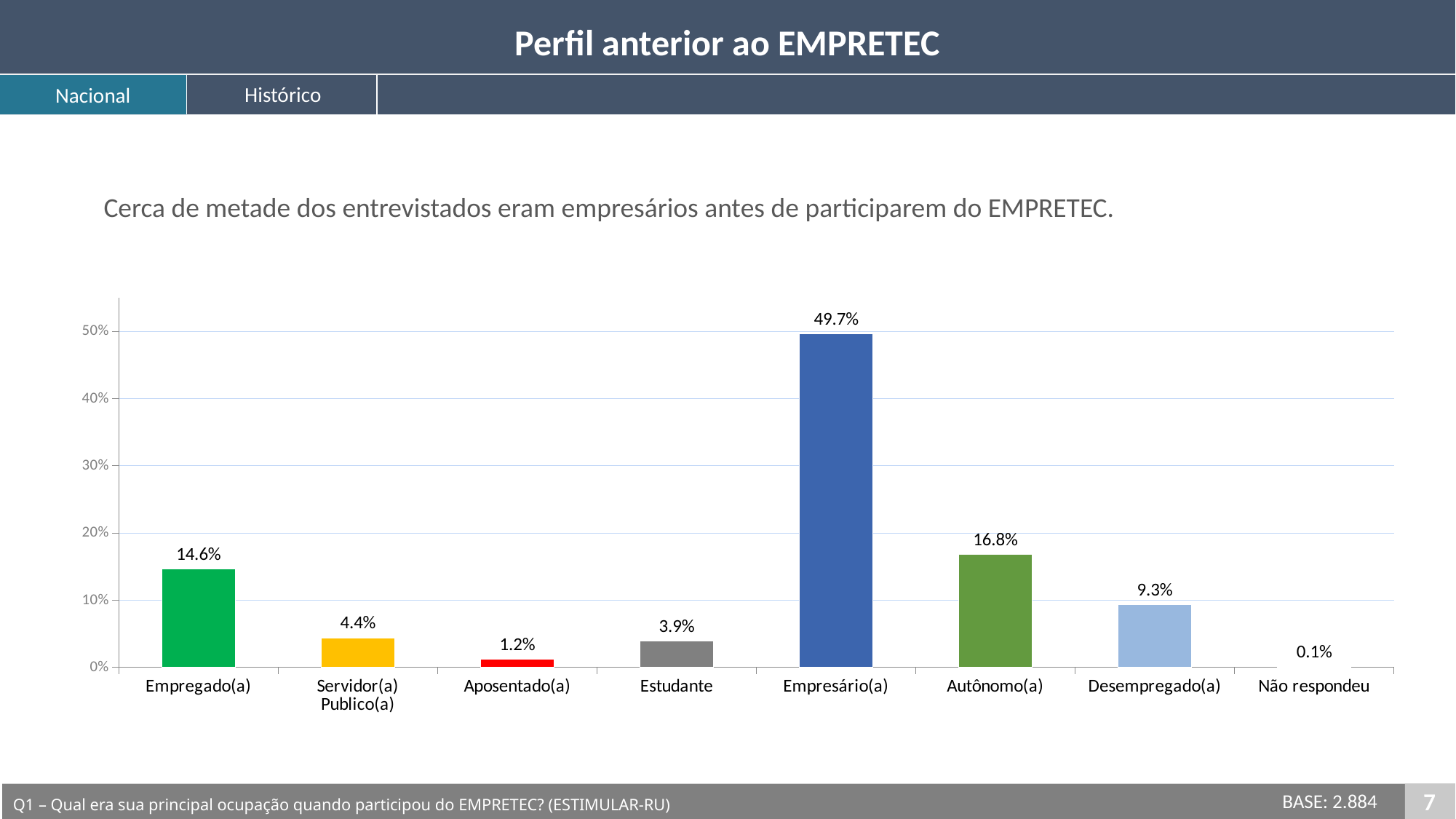
What is the value for Desempregado(a)? 9.3% What colour is the bar for Aposentado(a)? red Which is larger, the value for Estudante or the value for Aposentado(a)? Estudante Is the value for Empregado(a) greater or less than 10%? greater What is the difference between the values for Autônomo(a) and Empregado(a)? 2.2% What is the value for Empresário(a)? 49.7% How many categories are shown on the x axis? 8 Which category has the lowest value? Não respondeu What is the difference between the values for Empresário(a) and Autônomo(a)? 32.9% What kind of chart is shown on the slide? bar chart What is the value for Servidor(a) Publico(a)? 4.4% Which category has the highest value? Empresário(a)